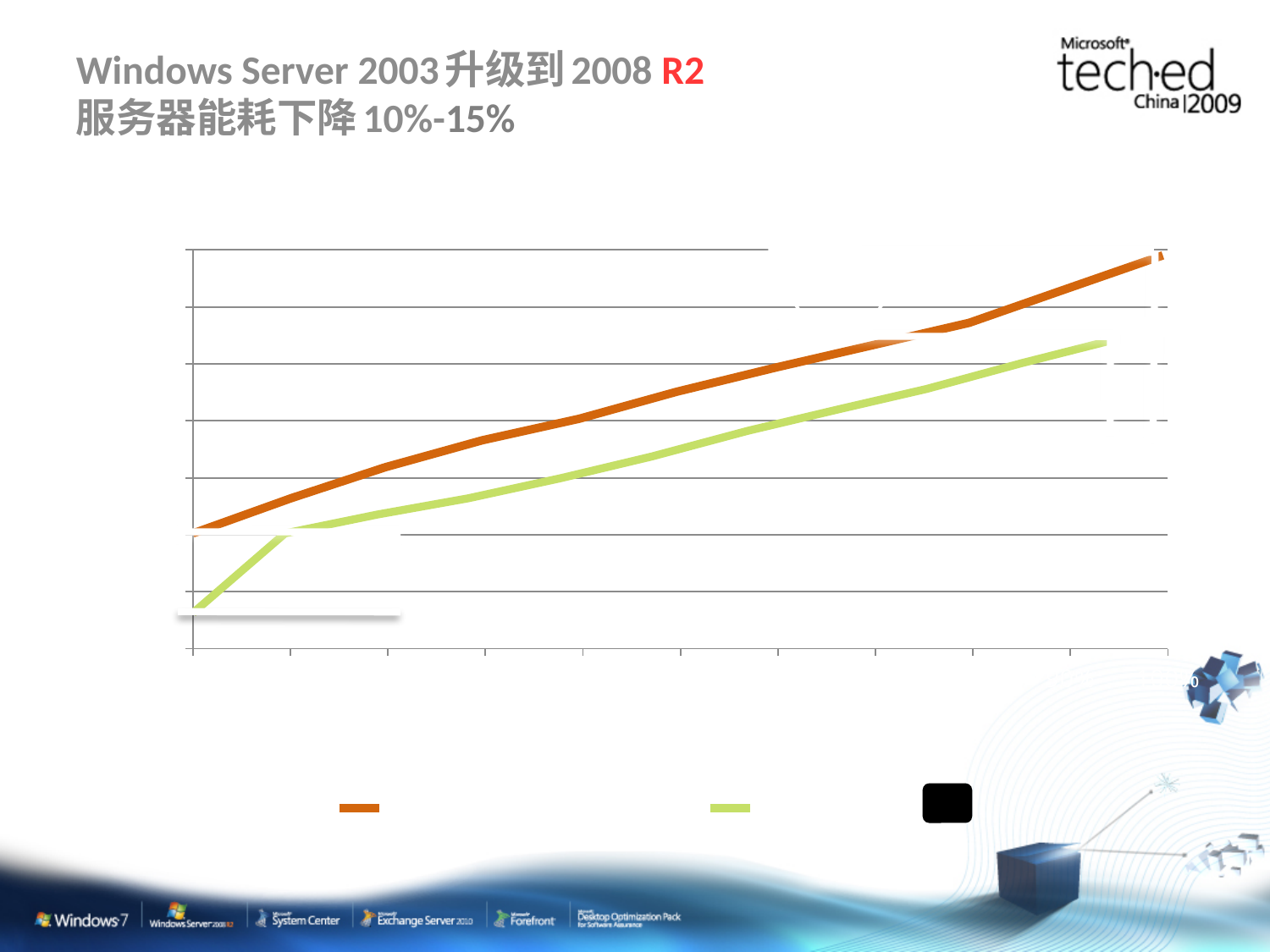
How many lines are plotted on the chart? 2 What kind of chart is shown on the slide? line chart Do the plotted values rise or fall from left to right along the x axis? rise What colour is the upper line on the chart? orange What colour is the lower line on the chart? green